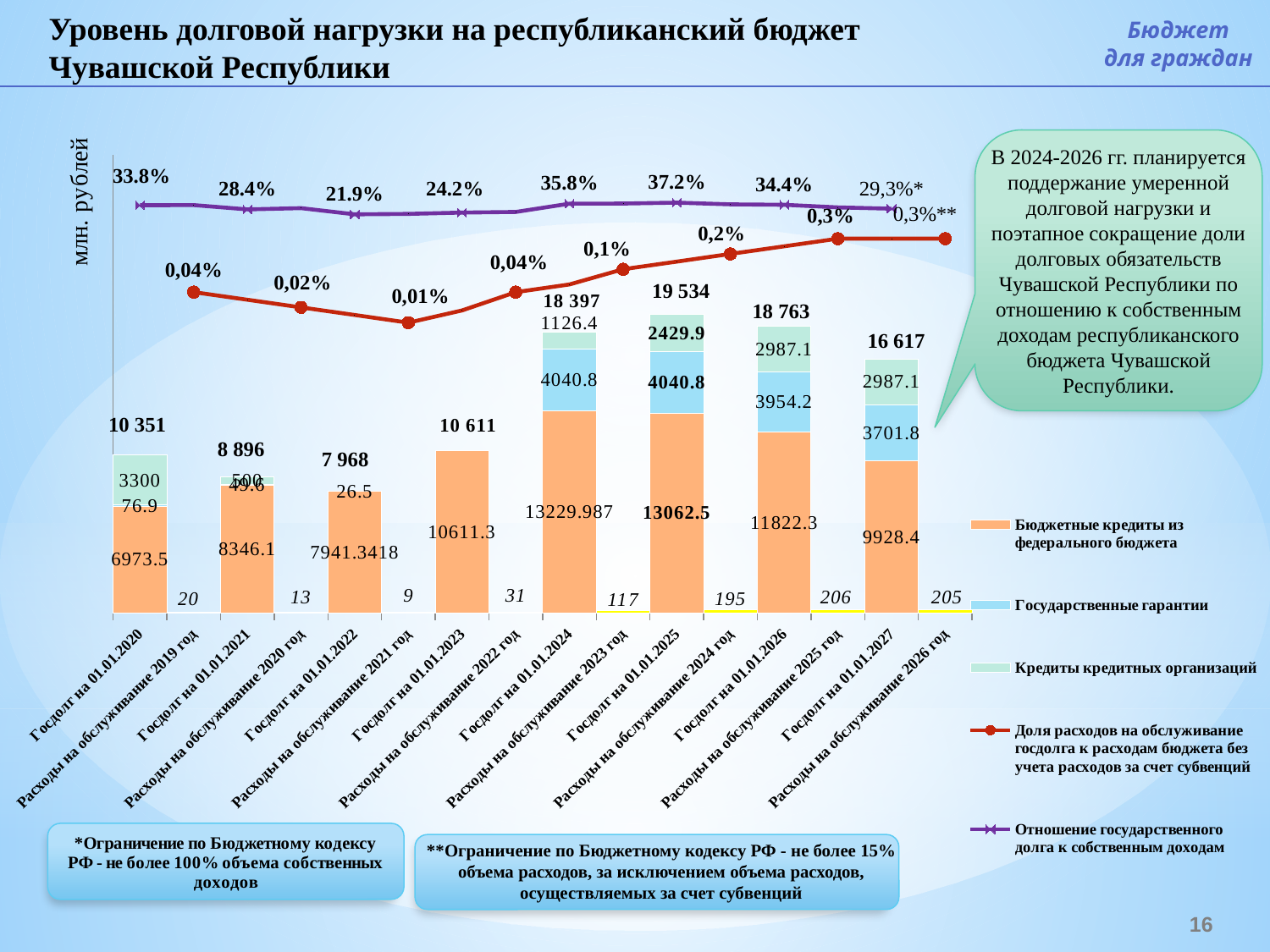
Which date has the lowest total state debt bar? Госдолг на 01.01.2022 What is the 'Отношение государственного долга к собственным доходам' value for Госдолг на 01.01.2025? 37.2% How many series does the legend list? 5 What is the value of 'Бюджетные кредиты из федерального бюджета' for Госдолг на 01.01.2024? 13229.987 What is the difference between the total state debt on 01.01.2025 (19 534) and on 01.01.2026 (18 763)? 771 Which date has the highest total state debt bar? Госдолг на 01.01.2025 What is the value of 'Государственные гарантии' for Госдолг на 01.01.2026? 3954.2 What is the value shown for Расходы на обслуживание 2025 год? 206 What is the total state debt (госдолг) shown above the stacked bar for 01.01.2025? 19 534 What is the lowest value on the 'Доля расходов на обслуживание госдолга' line? 0,01% Which is larger: 'Кредиты кредитных организаций' on 01.01.2024 or on 01.01.2025? 01.01.2025 What is the 'Доля расходов на обслуживание госдолга' value for Расходы на обслуживание 2024 год? 0,2%